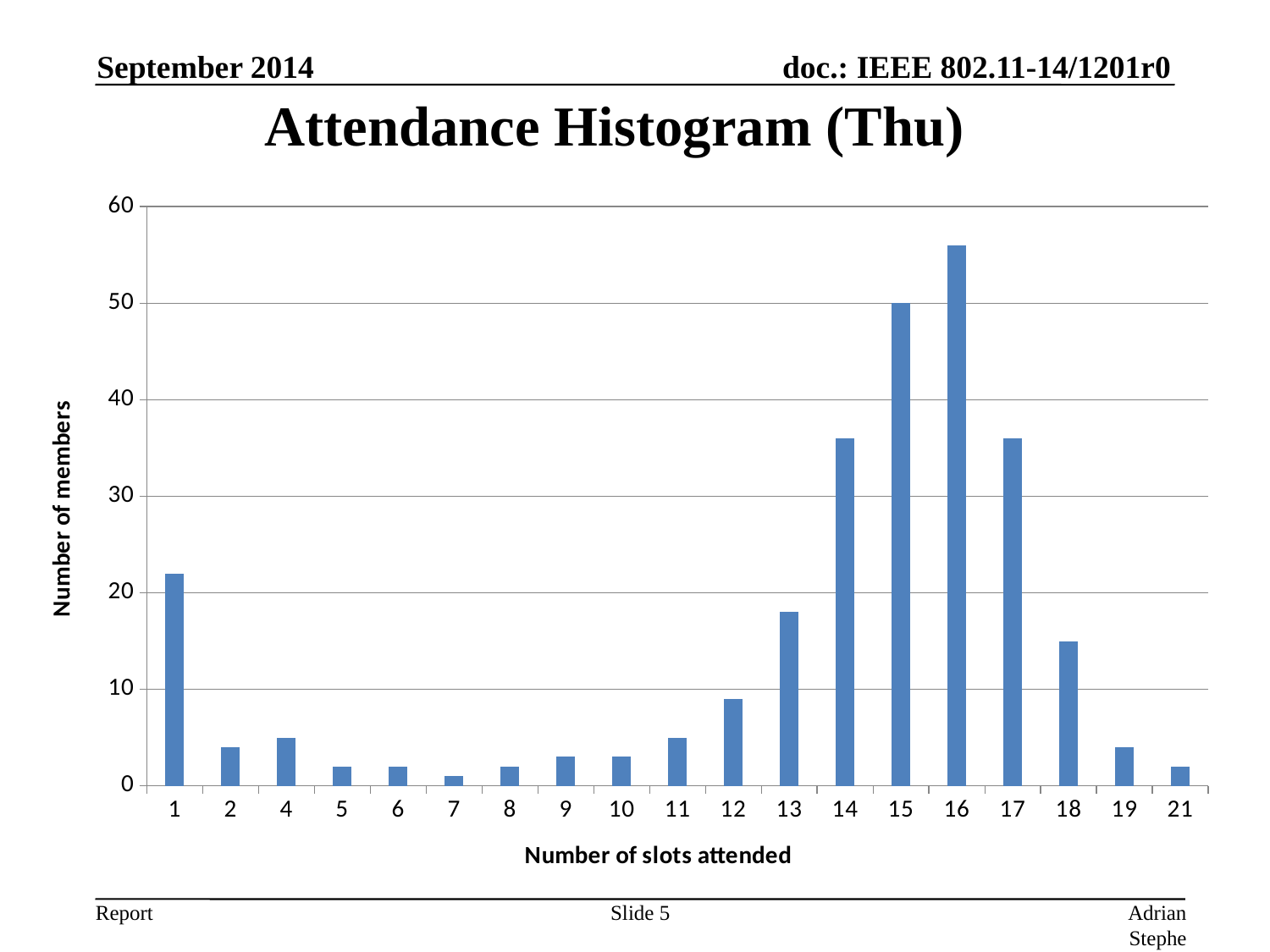
Which number of slots attended has the highest number of members? 16 Is the number of members for 14 slots attended greater or less than 40? less What type of chart is shown on the slide? bar chart Which has more members: 13 slots attended or 14 slots attended? 14 What is the number of members for 15 slots attended? 50 What is the label of the x axis? Number of slots attended Which has more members: 1 slot attended or 18 slots attended? 1 How many categories are shown on the x axis? 19 Is the number of members for 12 slots attended greater or less than 10? less What is the title of the chart? Attendance Histogram (Thu) Is the number of members for 16 slots attended greater or less than 50? greater